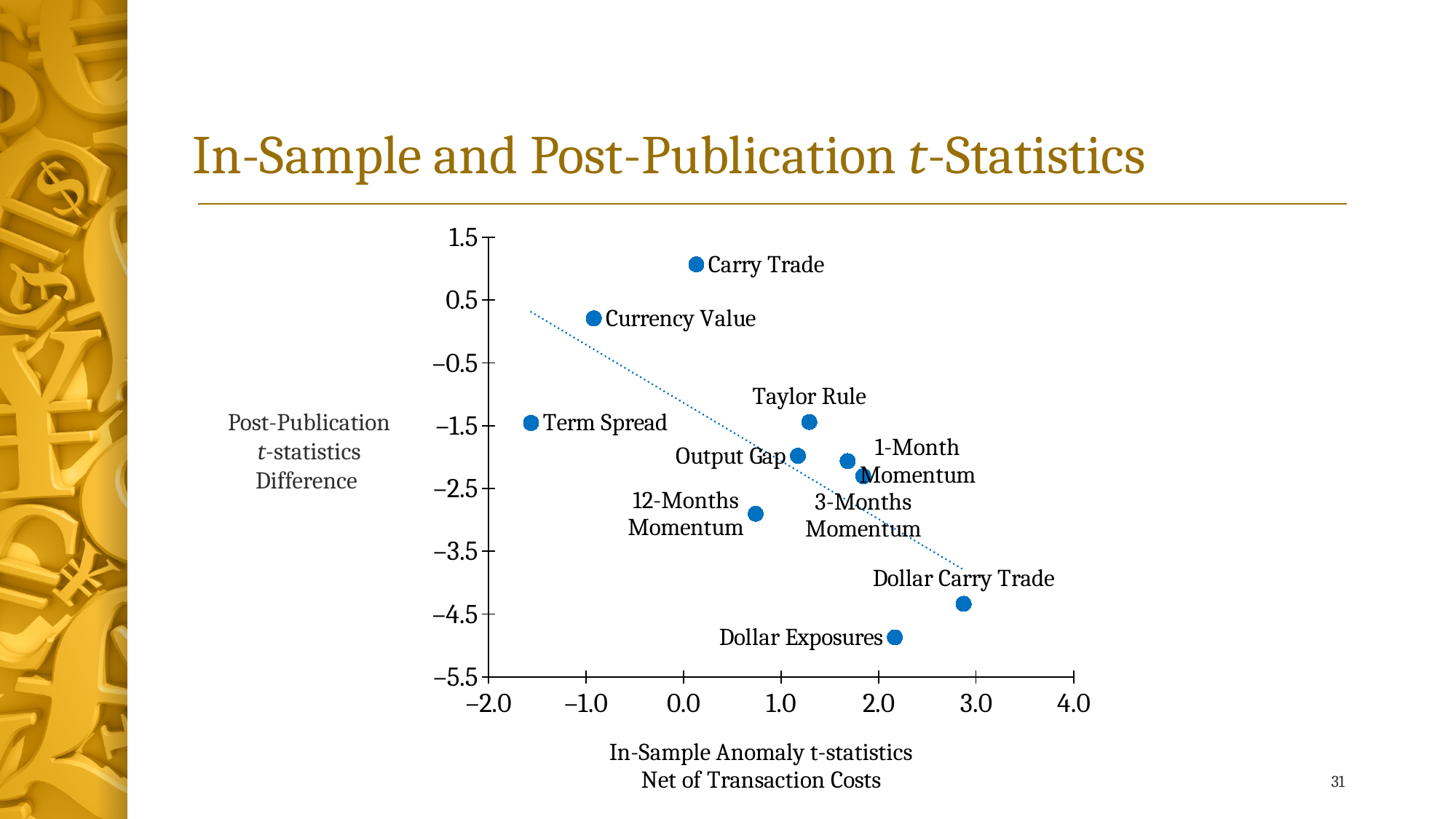
What kind of chart is shown on the slide? scatter chart Is the Post-Publication t-statistics Difference for Carry Trade greater or less than 0.5? greater Which point has the highest Post-Publication t-statistics Difference? Carry Trade How many labeled data points are plotted on the chart? 10 Which point has the highest In-Sample Anomaly t-statistic (furthest right on the x axis)? Dollar Carry Trade Is the In-Sample Anomaly t-statistic for Term Spread greater or less than -1.0? less Which point has the lowest In-Sample Anomaly t-statistic (furthest left on the x axis)? Term Spread Which has a higher Post-Publication t-statistics Difference, Carry Trade or Dollar Exposures? Carry Trade Is the Post-Publication t-statistics Difference for 12-Months Momentum greater or less than -2.5? less As the In-Sample Anomaly t-statistic increases along the x axis, does the Post-Publication t-statistics Difference generally rise or fall? fall Which point has the lowest Post-Publication t-statistics Difference? Dollar Exposures